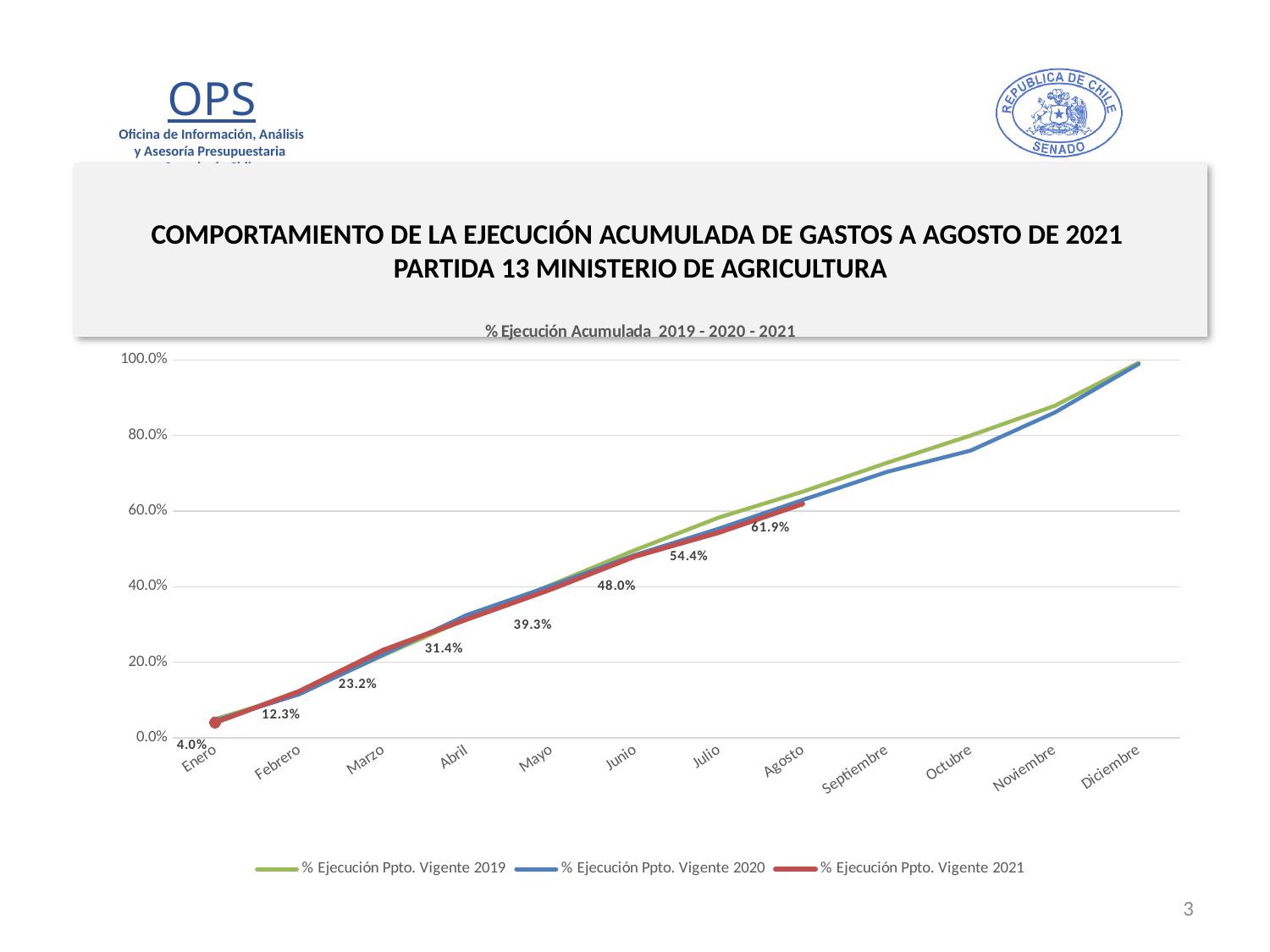
What type of chart is shown on the slide? line chart How many months are shown on the x axis? 12 Is the value for % Ejecución Ppto. Vigente 2020 in Octubre greater or less than 60.0%? greater What is the value for % Ejecución Ppto. Vigente 2021 in Agosto? 61.9% What is the value for % Ejecución Ppto. Vigente 2021 in Enero? 4.0% Do the values for % Ejecución Ppto. Vigente 2021 rise or fall from Enero to Agosto? rise What is the value for % Ejecución Ppto. Vigente 2021 in Abril? 31.4% What is the difference between the 2021 values for Agosto and Julio? 7.5% What is the difference between the 2021 values for Marzo and Febrero? 10.9% How many series does the legend list? 3 What is the value for % Ejecución Ppto. Vigente 2021 in Junio? 48.0% What is the title of the chart? % Ejecución Acumulada 2019 - 2020 - 2021